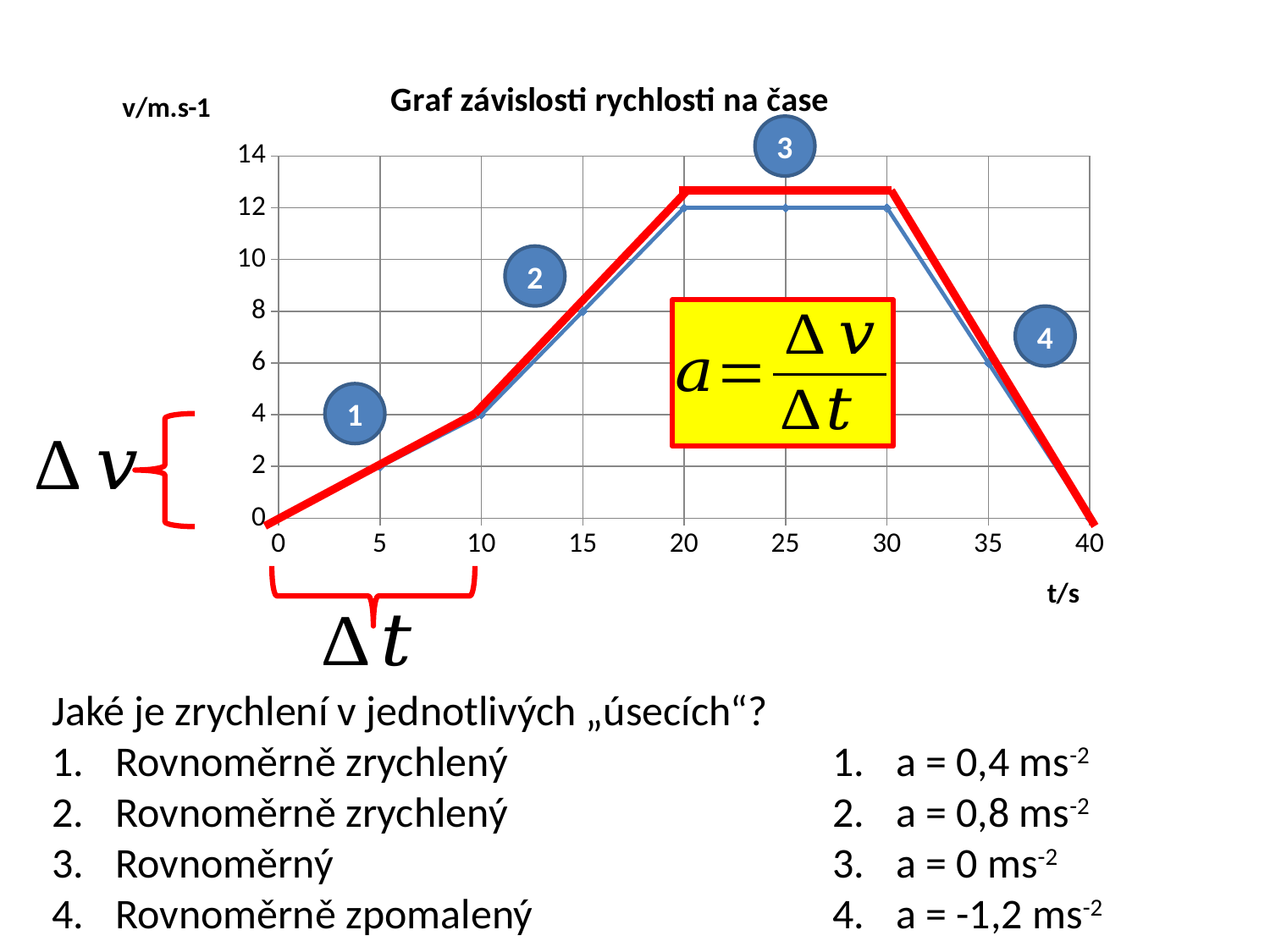
What is the velocity value at t = 15 s? 8 Which is larger, the velocity at t = 10 s or at t = 30 s? t = 30 s Does the velocity rise or fall between t = 30 s and t = 40 s? fall What is the velocity value at t = 10 s? 4 What is the highest velocity value reached on the chart? 12 By how much does the velocity increase between t = 10 s and t = 20 s? 8 What is the velocity value at t = 20 s? 12 What kind of chart is shown on the slide? line chart Does the velocity rise, fall or stay constant between t = 20 s and t = 30 s? stay constant Is the velocity at t = 35 s greater or less than 8? less What is the title of the chart? Graf závislosti rychlosti na čase What is the velocity value at t = 40 s? 0